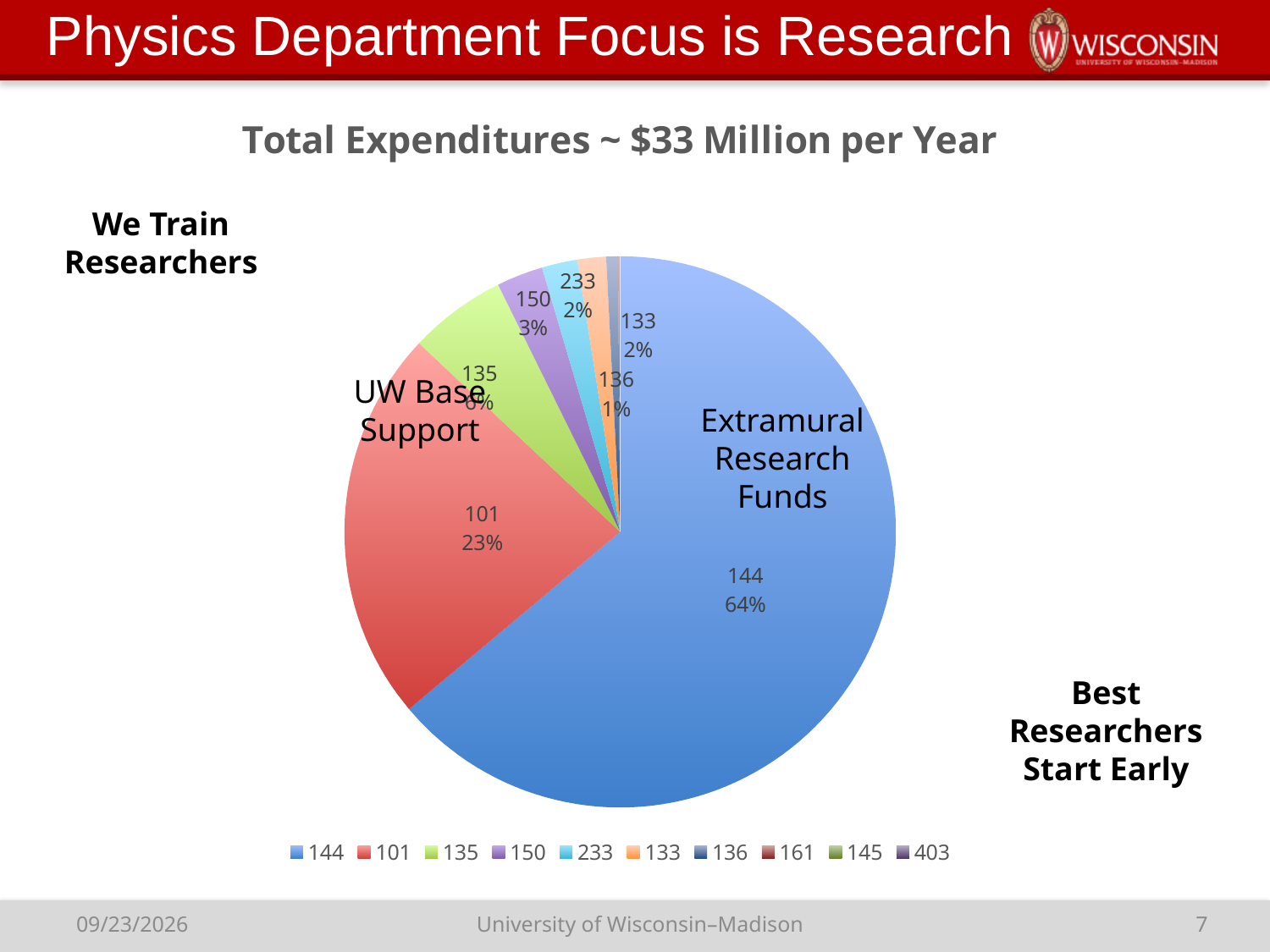
What share of the pie does the slice labeled 101 represent? 23% What kind of chart is shown on the slide? pie chart Which slice is larger, the one labeled 101 or the one labeled 150? 101 What share of the pie does the slice labeled 136 represent? 1% What is the title shown above the pie chart? Total Expenditures ~ $33 Million per Year How many entries does the legend of the pie chart list? 10 By how many percentage points does the share of slice 144 exceed the share of slice 101? 41 percentage points Which legend category has the largest slice of the pie? 144 What share of the pie does the slice labeled 144 represent? 64% What text label is placed on the largest slice of the pie chart? Extramural Research Funds